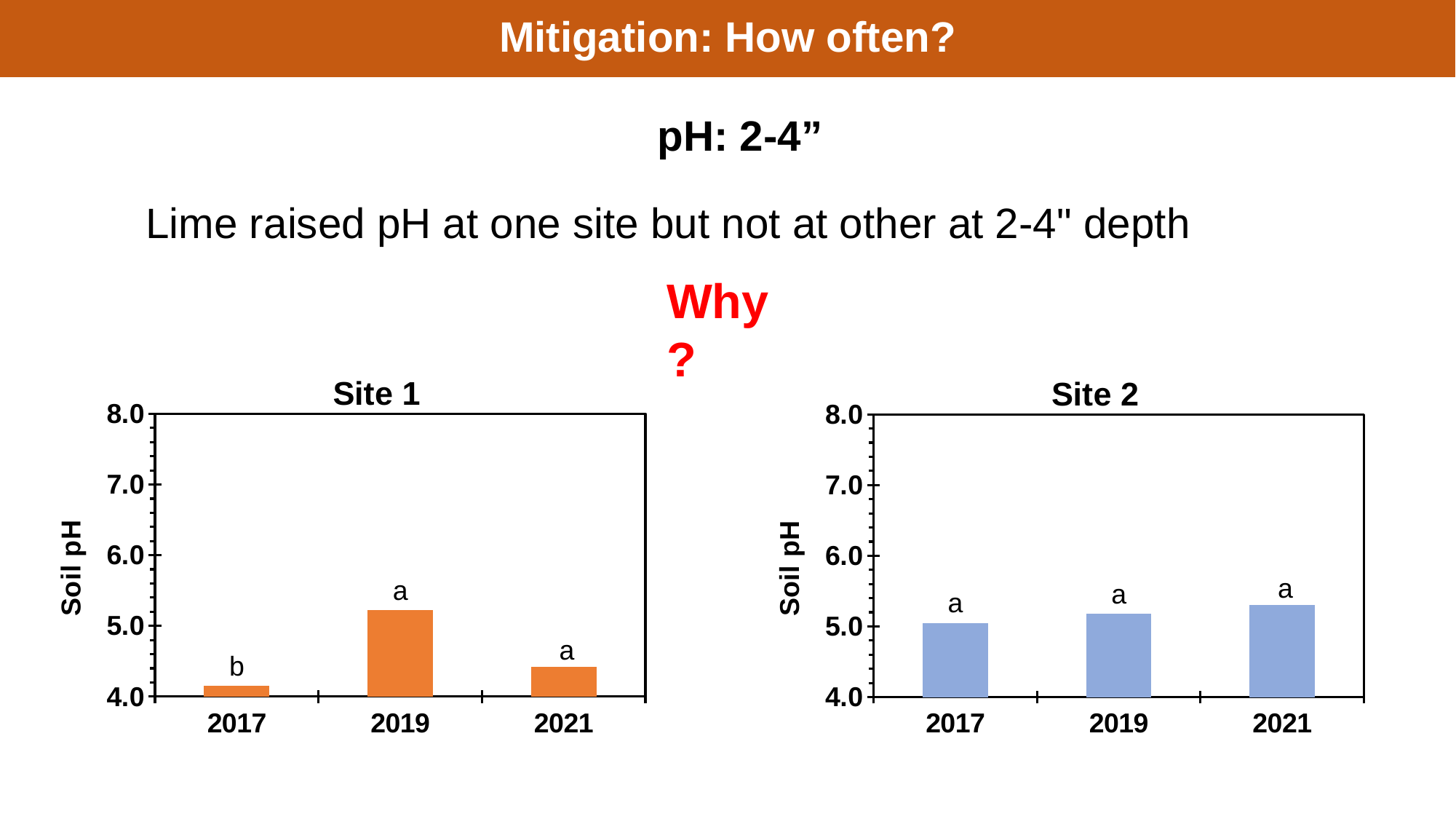
In the Site 1 chart, what letter is printed above the 2017 bar? b What is the y-axis label on the Site 2 chart? Soil pH In the Site 1 chart, which year has the highest soil pH? 2019 In the Site 1 chart, which year has the lowest soil pH? 2017 In the Site 1 chart, is the soil pH for 2017 greater or less than 5.0? less How many years are shown on the x axis of the Site 2 chart? 3 In the Site 1 chart, which year has the larger soil pH, 2019 or 2021? 2019 In the Site 2 chart, do the soil pH values rise or fall from 2017 to 2021? rise In the Site 1 chart, is the soil pH for 2019 greater or less than 5.0? greater In the Site 2 chart, is the soil pH for 2021 greater or less than 5.0? greater What kind of chart is the Site 1 chart? bar chart